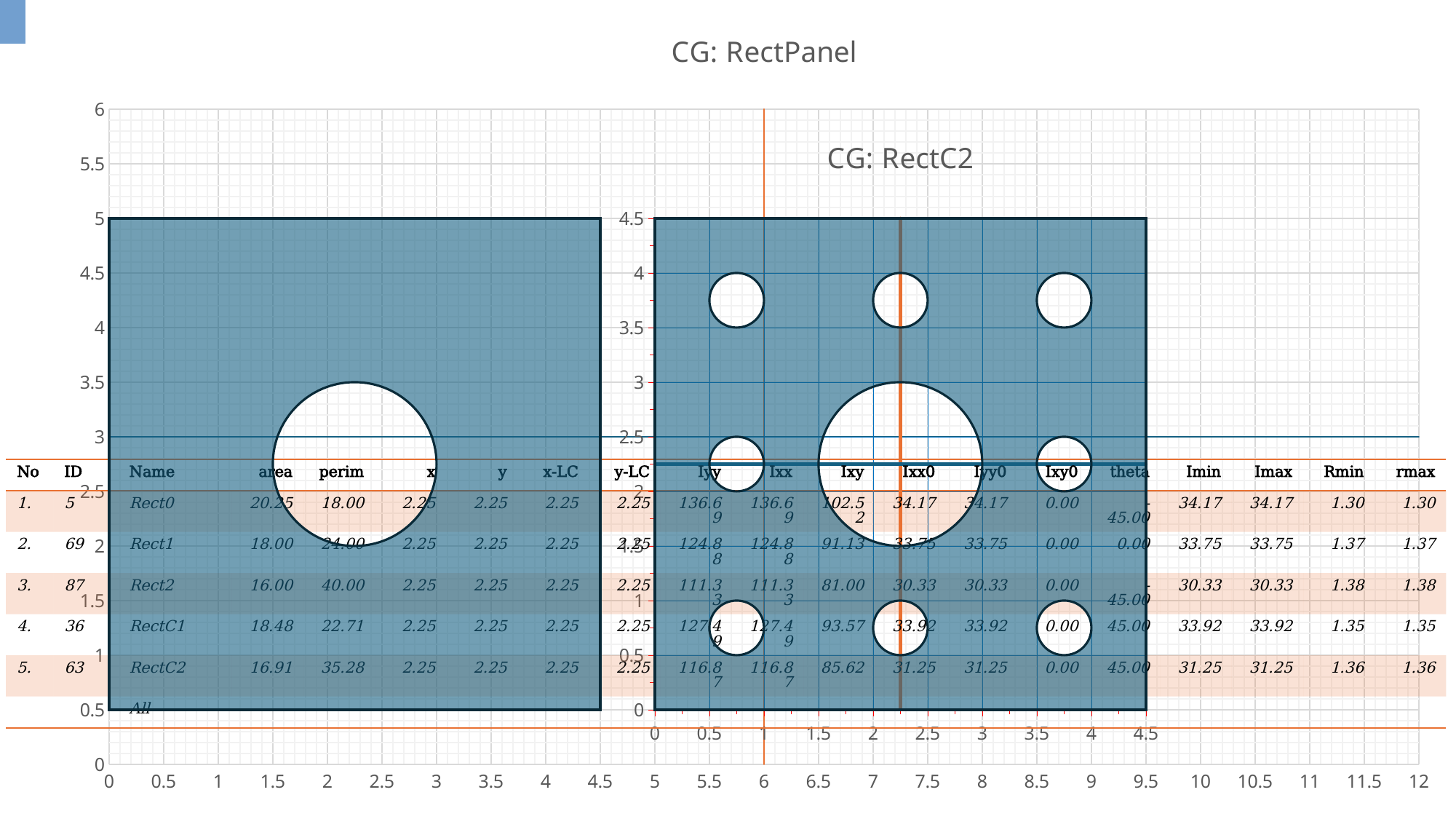
What is the title of the chart on the left of the slide? CG: RectPanel What is the title of the chart on the right of the slide? CG: RectC2 In the CG: RectPanel chart, how many circular holes are drawn in the shaded rectangle? 1 In the CG: RectC2 chart, what is the highest tick value shown on its horizontal axis? 4.5 In the CG: RectC2 chart, what is the highest tick value shown on its vertical axis? 4.5 In the CG: RectC2 chart, how many circular holes are drawn in the shaded rectangle? 9 In the CG: RectPanel chart, what is the highest tick value shown on the vertical axis? 6